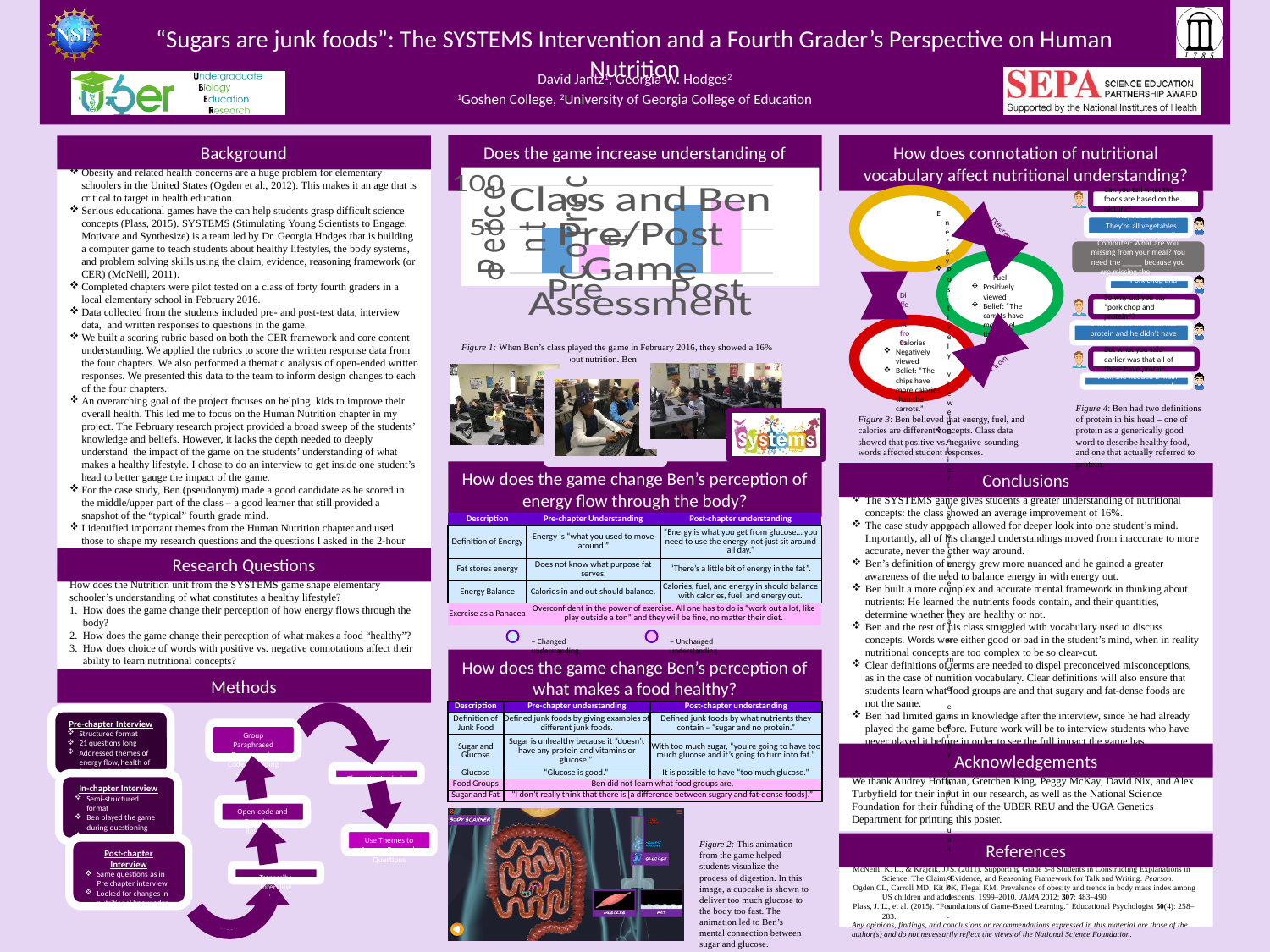
In the 'Class and Ben Pre/Post Game Assessment' chart, is the blue bar for Post greater or less than 100? less In the 'Class and Ben Pre/Post Game Assessment' chart, which is larger for the pink series: Pre or Post? Post How many categories are shown on the x axis of the 'Class and Ben Pre/Post Game Assessment' chart? 2 In the 'Class and Ben Pre/Post Game Assessment' chart, do the blue bars rise or fall from Pre to Post? rise In the 'Class and Ben Pre/Post Game Assessment' chart, which is larger for the blue series: Pre or Post? Post In the 'Class and Ben Pre/Post Game Assessment' chart, which category has the highest blue bar? Post In the 'Class and Ben Pre/Post Game Assessment' chart, do the pink bars rise or fall from Pre to Post? rise What are the two categories on the x axis of the 'Class and Ben Pre/Post Game Assessment' chart? Pre and Post What is the y-axis label of the 'Class and Ben Pre/Post Game Assessment' chart? Percent Correct In the 'Class and Ben Pre/Post Game Assessment' chart, is the pink bar for Post greater or less than 50? greater What kind of chart is the 'Class and Ben Pre/Post Game Assessment' chart? bar chart